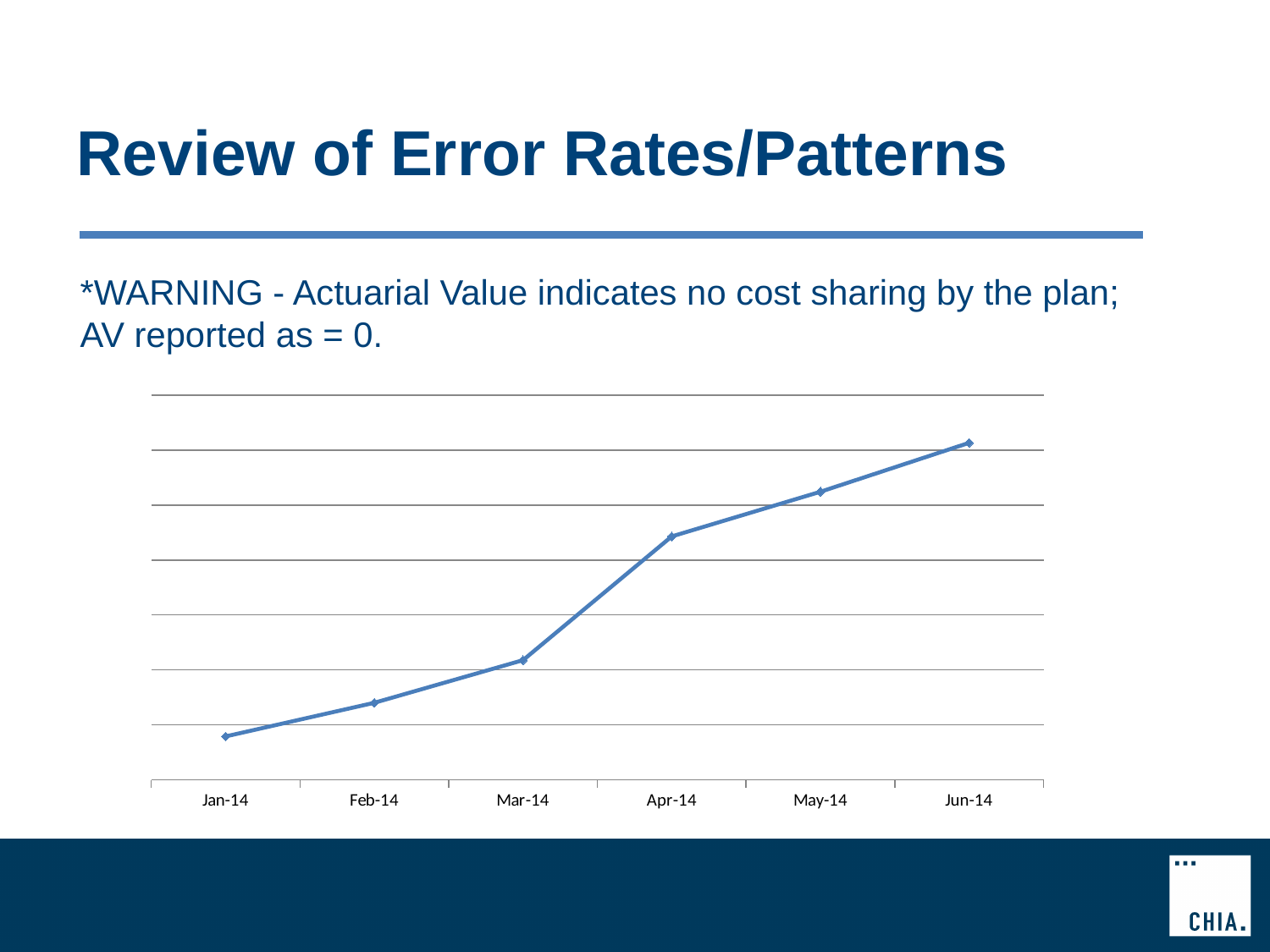
Which month has the highest plotted value? Jun-14 How many months are plotted along the x axis of the chart? 6 Which is larger, the value for Mar-14 or the value for Apr-14? Apr-14 What kind of chart is shown on the slide? line chart Which is larger, the value for Feb-14 or the value for May-14? May-14 What is the last month shown on the x axis of the chart? Jun-14 Between which two consecutive months does the line show the steepest increase? Mar-14 to Apr-14 What is the first month shown on the x axis of the chart? Jan-14 Do the plotted values rise or fall from Jan-14 to Jun-14? rise Which month has the lowest plotted value? Jan-14